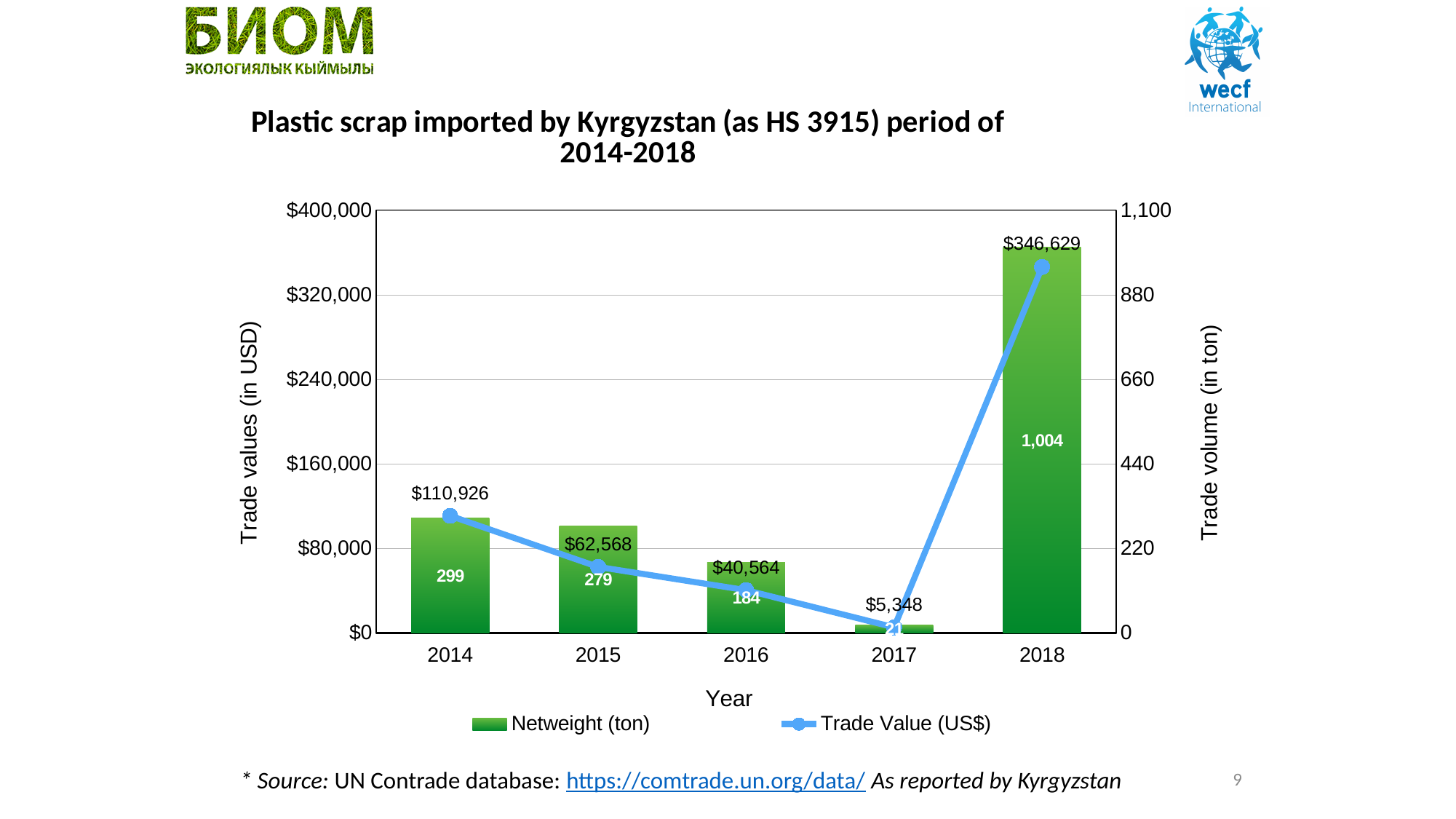
What was the net weight (in tons) of plastic scrap imported in 2014? 299 Which year had the lowest trade value of plastic scrap imports? 2017 Which series is plotted as a line in the chart? Trade Value (US$) What was the trade value of plastic scrap imported by Kyrgyzstan in 2018? $346,629 How many years are shown on the x axis of the chart? 5 What was the trade value of plastic scrap imports in 2016? $40,564 What was the net weight of plastic scrap imported in 2015? 279 Which year had the highest net weight of plastic scrap imports? 2018 How many series does the chart legend list? 2 How did the trade value change from 2014 to 2017? It fell each year Which year had a larger net weight of imports, 2015 or 2016? 2015 What is the difference in trade value between 2014 and 2015? $48,358